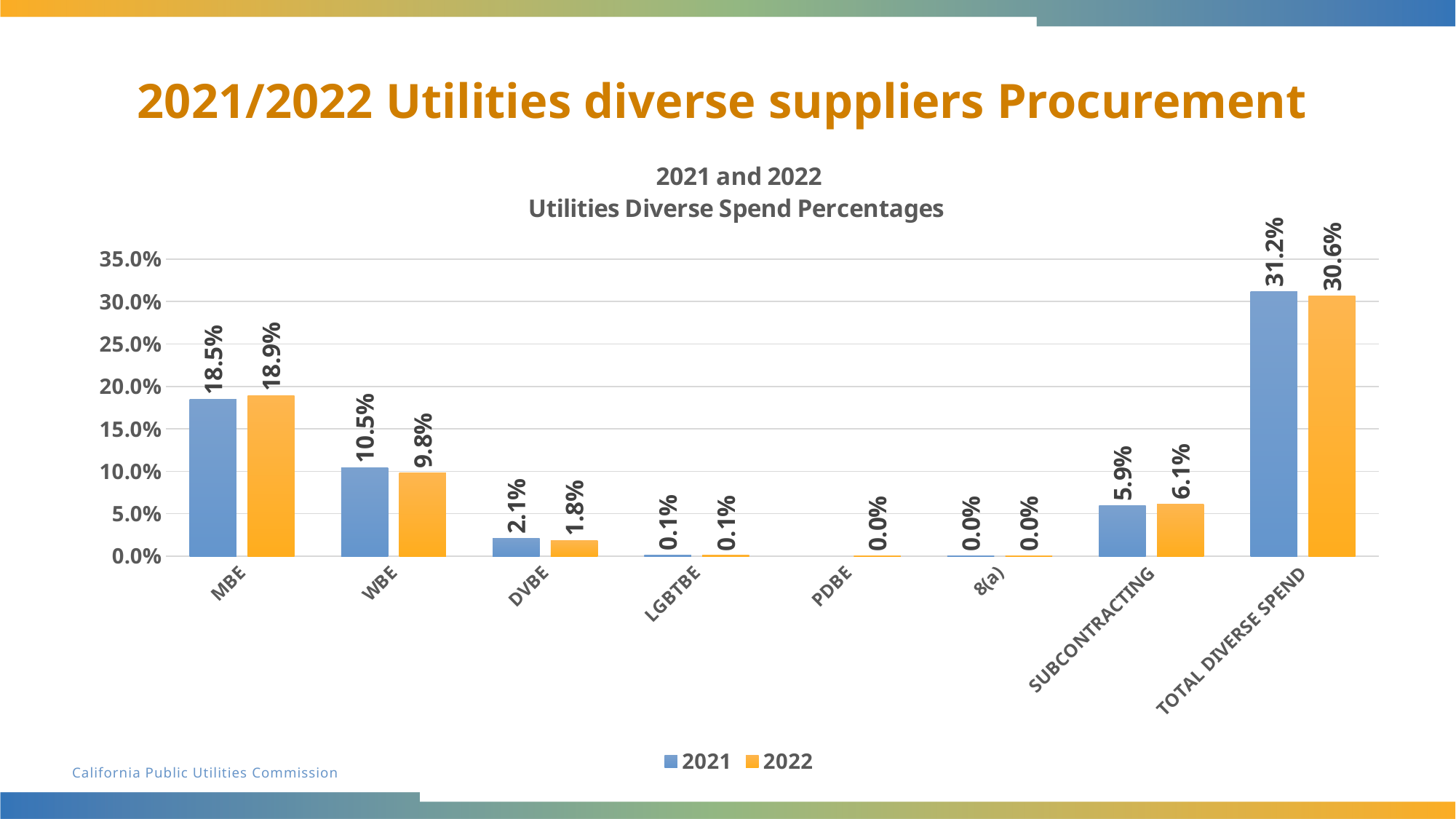
Which is larger for WBE, the 2021 value or the 2022 value? 2021 What is the 2021 value for SUBCONTRACTING? 5.9% Which category has the highest 2021 value? TOTAL DIVERSE SPEND What kind of chart is shown on the slide? bar chart What is the 2022 value for TOTAL DIVERSE SPEND? 30.6% How many series does the legend list? 2 What is the 2022 value for WBE? 9.8% Excluding TOTAL DIVERSE SPEND, which category has the highest 2022 value? MBE What is the difference between the 2021 and 2022 values for DVBE? 0.3% What is the 2021 value for MBE? 18.5% How many categories are shown on the x axis? 8 Is the 2021 value for TOTAL DIVERSE SPEND greater or less than 30.0%? greater